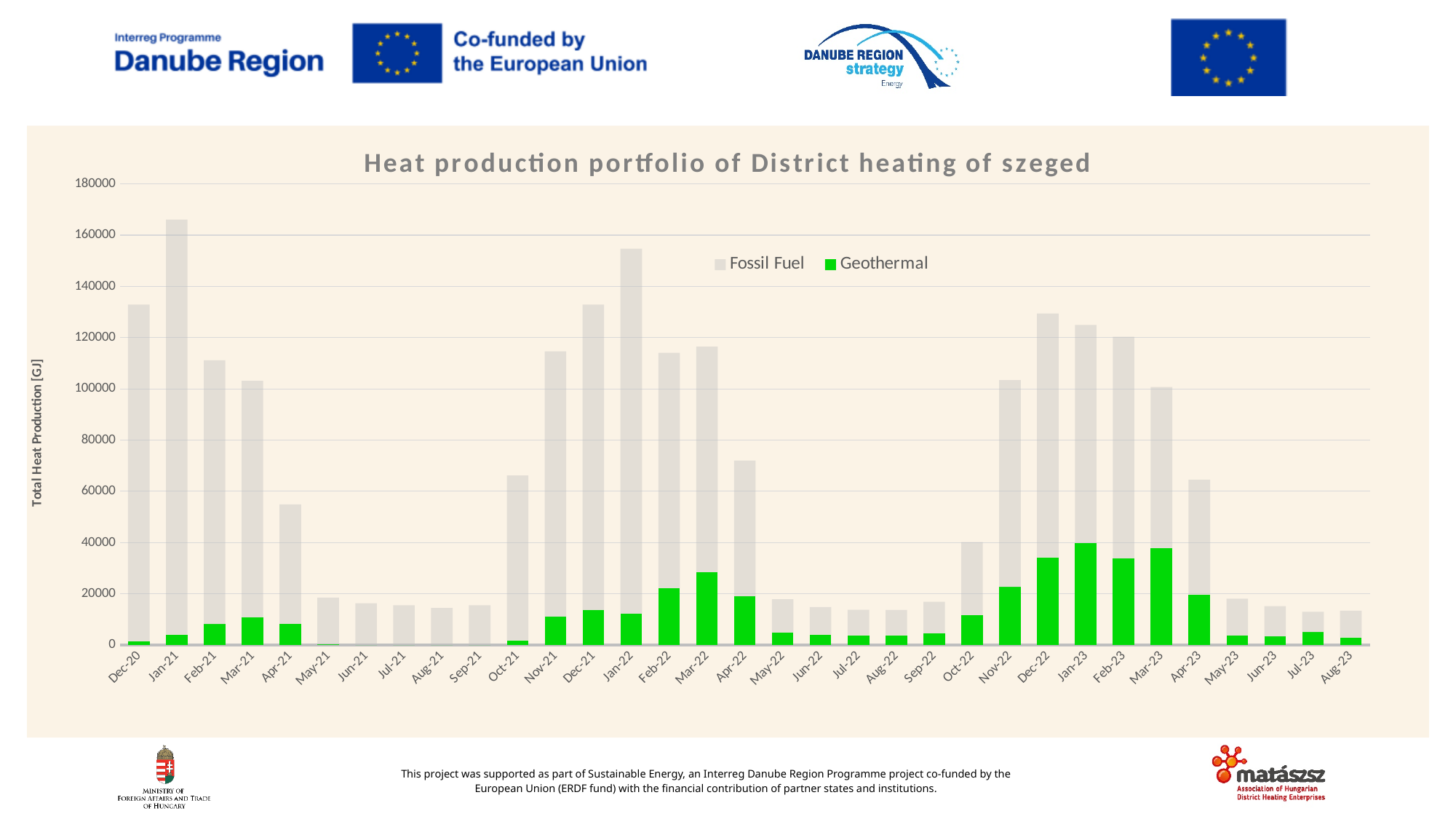
How many months are plotted along the x axis? 33 Is the Geothermal value for Dec-22 greater or less than 20000? greater Which month has the larger Geothermal value, Jan-21 or Jan-23? Jan-23 Is the total heat production for Jan-22 greater or less than 160000? less Is the total heat production for Jan-21 greater or less than 160000? greater What is the label of the y axis? Total Heat Production [GJ] Which two series are shown in the legend? Fossil Fuel and Geothermal Which month has the highest total heat production? Jan-21 How many series does the legend list? 2 What kind of chart is shown on the slide? Stacked bar chart Which month has the larger total heat production, Jan-21 or Jan-22? Jan-21